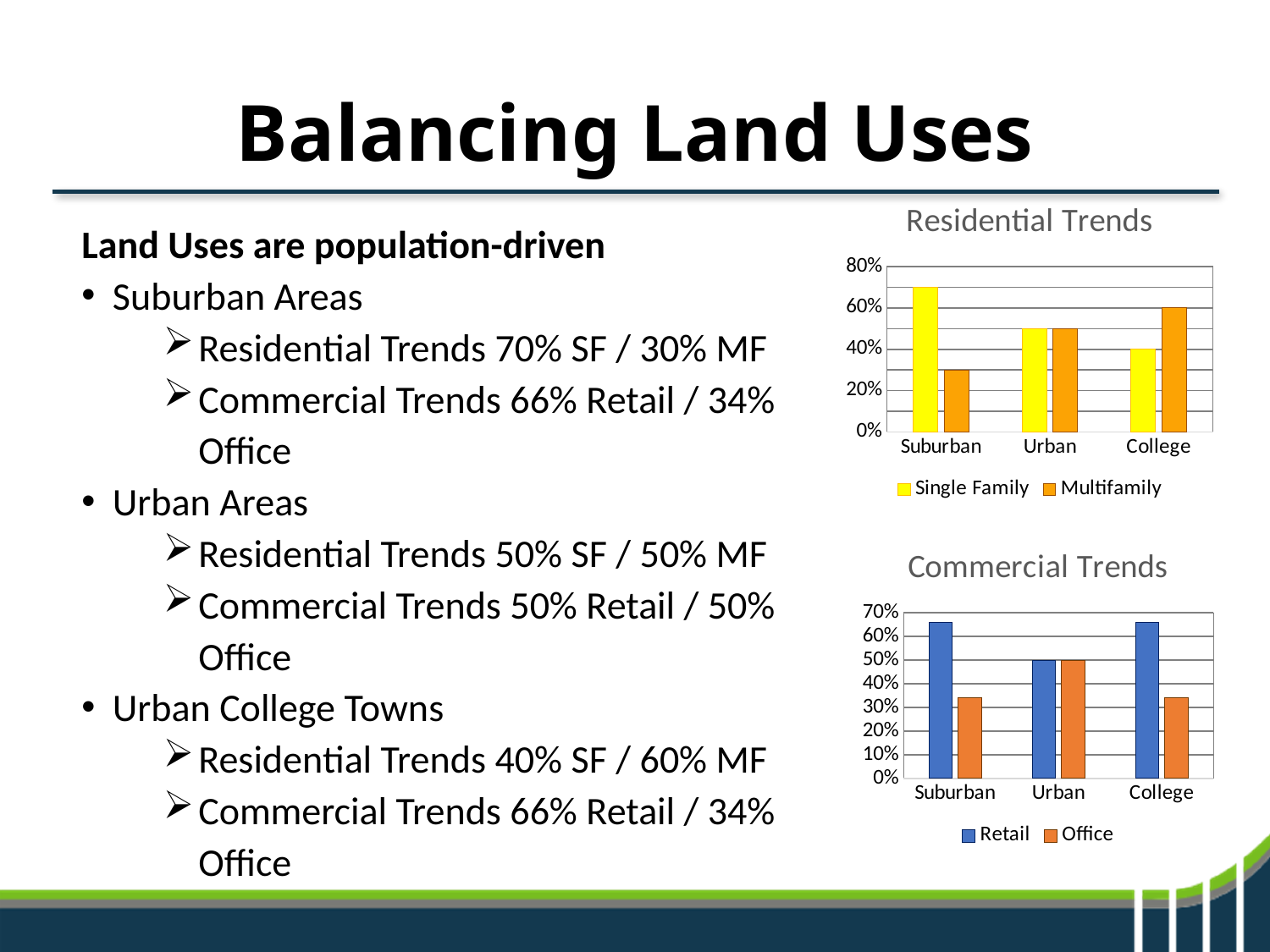
In the Residential Trends chart, is the Single Family value for Suburban greater or less than 60%? greater What kind of chart is the Commercial Trends chart? bar chart In the Residential Trends chart, what is the Single Family value for College? 40% In the Residential Trends chart, which category has the highest Single Family value? Suburban In the Commercial Trends chart, is the Retail value for College greater or less than 60%? greater In the Commercial Trends chart, what is the Office value for Urban? 50% How many series does the legend of the Commercial Trends chart list? 2 In the Residential Trends chart, what is the difference between the Multifamily and Single Family values for College? 20% In the Residential Trends chart, is the Multifamily value for Suburban greater or less than 40%? less In the Residential Trends chart, what is the Multifamily value for College? 60% In the Commercial Trends chart, what is the Retail value for Urban? 50%